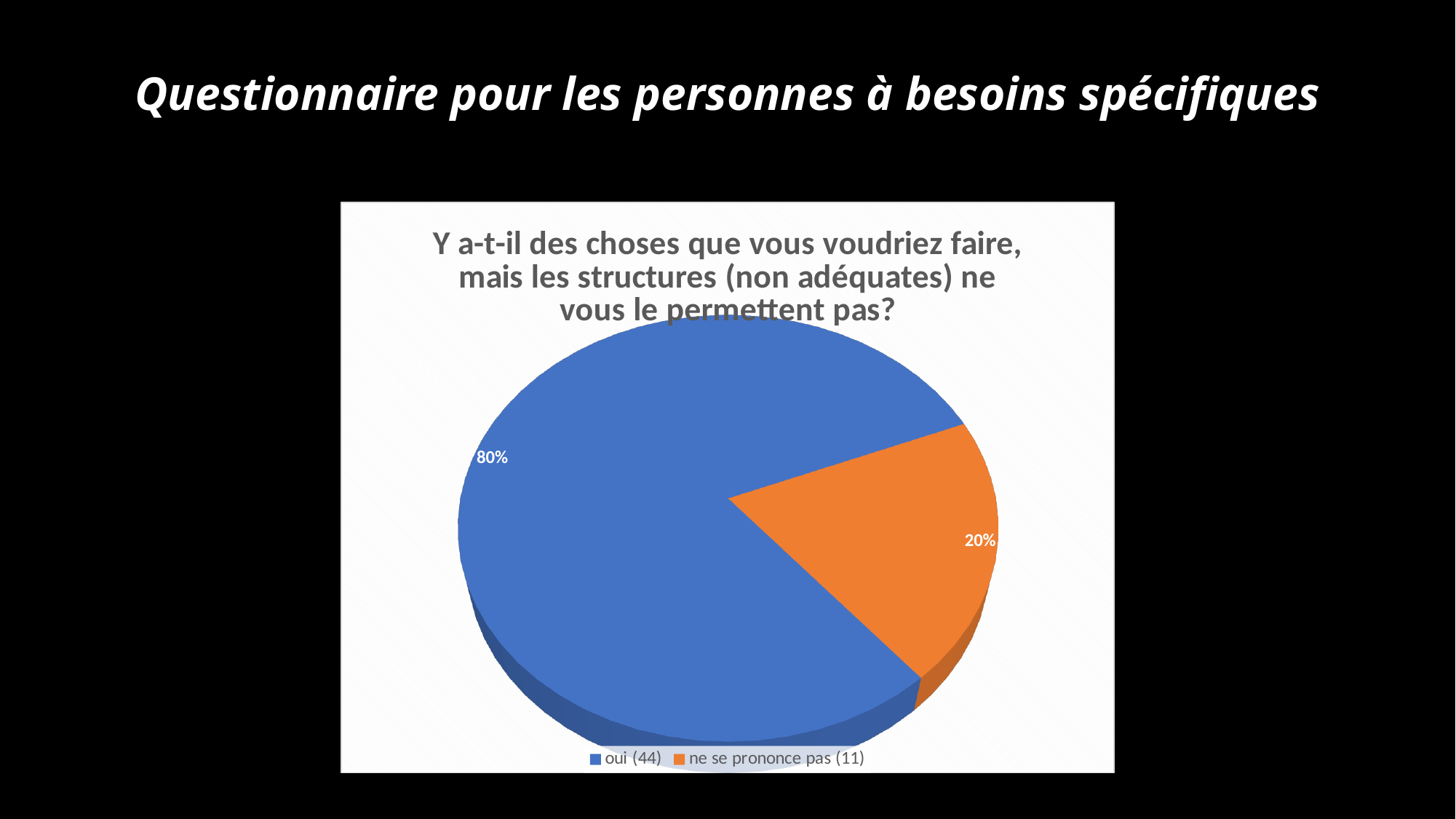
What percentage of the pie is labelled for "oui (44)"? 80% How many slices does the pie chart have? 2 What is the title of the chart? Y a-t-il des choses que vous voudriez faire, mais les structures (non adéquates) ne vous le permettent pas? What percentage of the pie is labelled for "ne se prononce pas (11)"? 20% What is the difference in percentage points between the "oui (44)" slice and the "ne se prononce pas (11)" slice? 60 percentage points What kind of chart is shown on the slide? pie chart How many entries does the legend list? 2 Which category has the smallest share of the pie? ne se prononce pas (11) Which slice is larger: "oui (44)" or "ne se prononce pas (11)"? oui (44) Which category has the largest share of the pie? oui (44) How many respondents answered "oui" according to the legend? 44 What colour is the "oui (44)" slice? blue